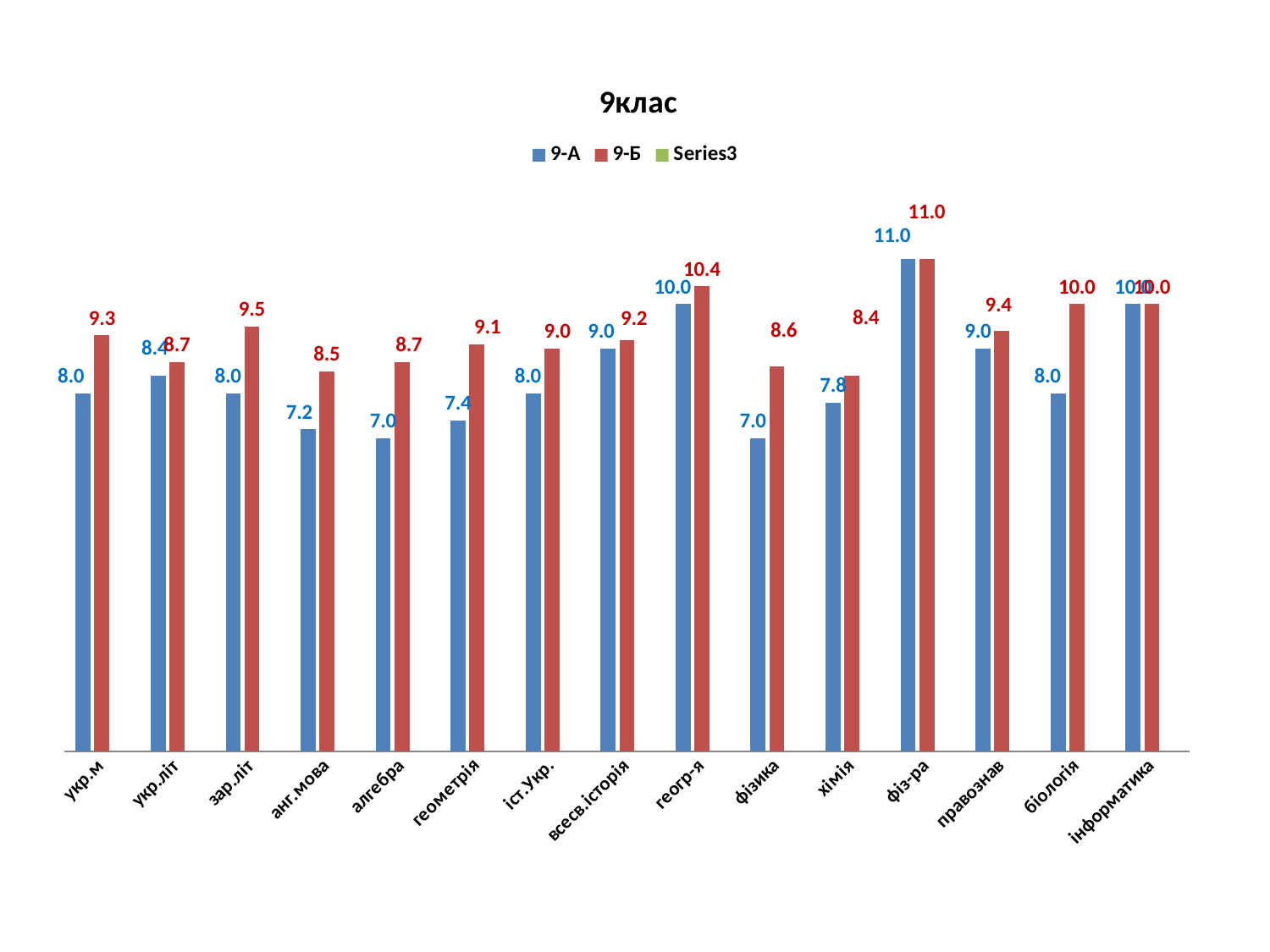
What is the difference between 9-Б and 9-А in біологія? 2.0 What is the value for 9-А in анг.мова? 7.2 How many subjects are shown on the x axis? 15 Which subject has the highest value for 9-Б? фіз-ра How many series does the legend list? 3 Which subject has the lowest value for 9-Б? хімія What is the value for 9-Б in хімія? 8.4 What type of chart is shown? bar chart What is the difference between 9-Б and 9-А in алгебра? 1.7 What is the value for 9-А in геометрія? 7.4 What is the value for 9-Б in зар.літ? 9.5 Which is larger in укр.м, the value for 9-А or for 9-Б? 9-Б